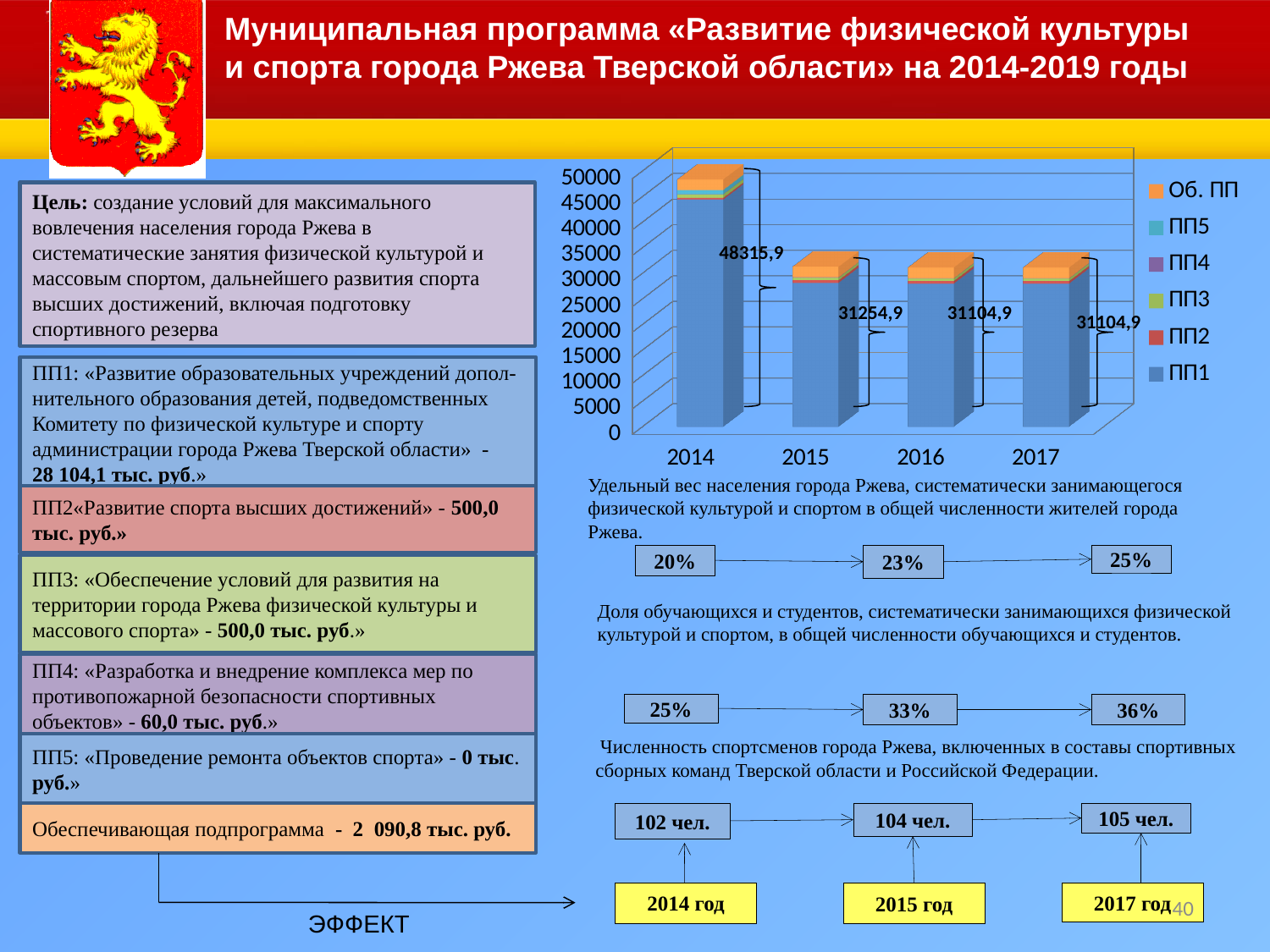
What kind of chart is shown on the slide? stacked bar chart How many series does the legend of the bar chart list? 6 Which year has the highest total value in the bar chart? 2014 How many years are shown on the x axis of the bar chart? 4 Which year has the lowest total value in the bar chart? 2016 and 2017 (31104,9) Which is larger, the total for 2014 or the total for 2015? 2014 What is the total value labelled on the bar for 2014? 48315,9 What is the difference between the labelled totals for 2014 and 2015? 17061,0 Is the total for 2015 greater or less than 35000? less What is the total value labelled on the bar for 2015? 31254,9 What is the total value labelled on the bar for 2016? 31104,9 What is the difference between the labelled totals for 2015 and 2016? 150,0